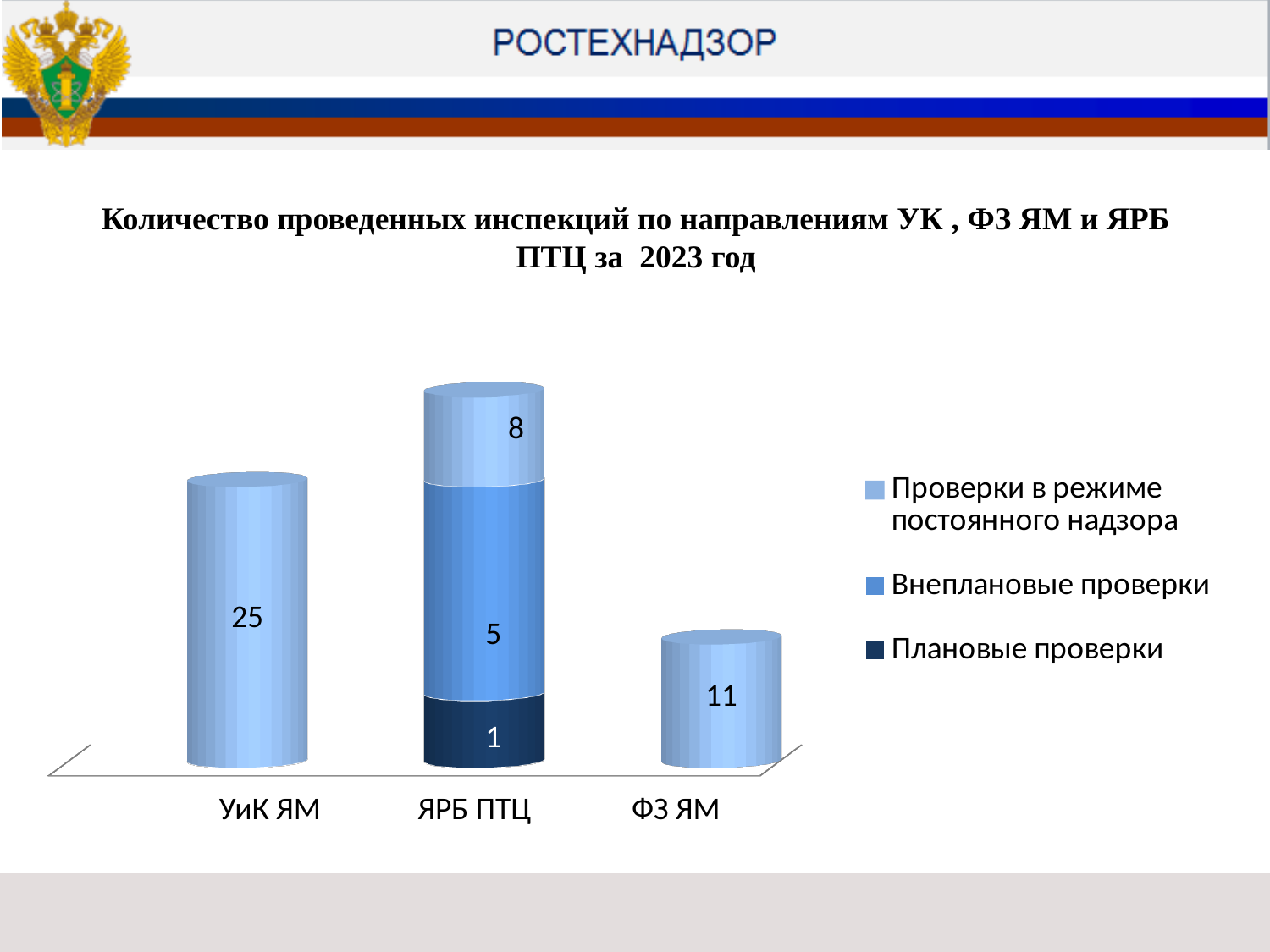
What is the difference between the Проверки в режиме постоянного надзора values for УиК ЯМ and ФЗ ЯМ? 14 Which is larger: the Внеплановые проверки value for ЯРБ ПТЦ or the Плановые проверки value for ЯРБ ПТЦ? Внеплановые проверки What is the value for Внеплановые проверки for ЯРБ ПТЦ? 5 Which category has the lowest total number of inspections? ФЗ ЯМ How many series does the legend list? 3 What is the value for Проверки в режиме постоянного надзора for УиК ЯМ? 25 What is the value for Проверки в режиме постоянного надзора for ЯРБ ПТЦ? 8 How many categories are shown on the x axis? 3 What is the value for Проверки в режиме постоянного надзора for ФЗ ЯМ? 11 What is the value for Плановые проверки for ЯРБ ПТЦ? 1 What is the total of the stacked bar for ЯРБ ПТЦ? 14